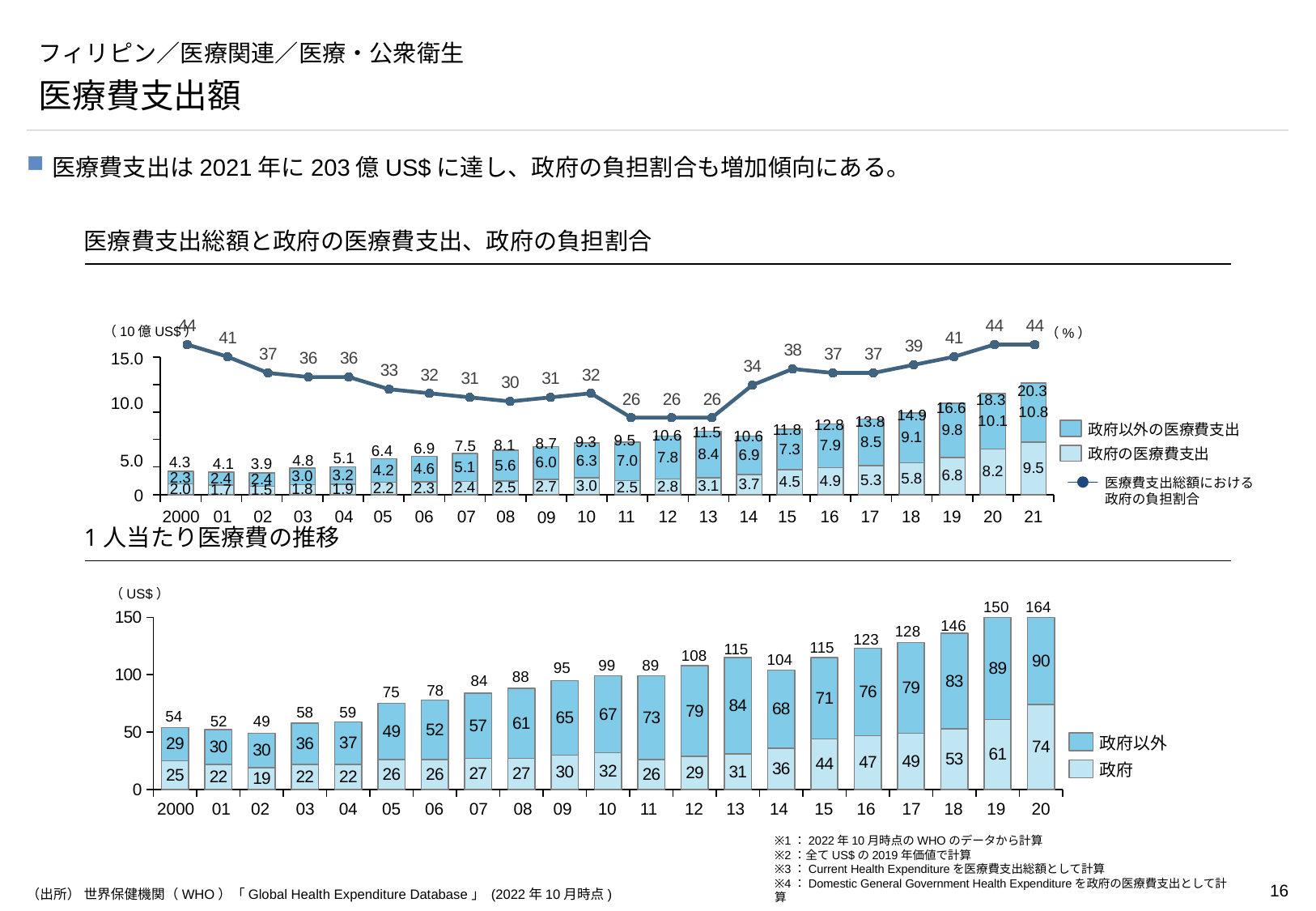
What kind of chart is the bottom chart (1人当たり医療費の推移)? stacked bar chart In the top chart, what is the government health expenditure (政府の医療費支出) for 2020? 8.2 In the top chart, what is the government's share of total health expenditure (政府の負担割合) in 2011? 26 In the top chart, how many series does the legend list? 3 In the bottom chart, how many years are shown on the x axis? 21 In the top chart (医療費支出総額と政府の医療費支出、政府の負担割合), what is the total health expenditure for 2021? 20.3 In the top chart, what is the difference between the non-government expenditure (10.8) and the government expenditure (9.5) in 2021? 1.3 In the top chart, which year has the lowest total health expenditure? 2002 In the bottom chart, is the per-capita total for 2013 larger or smaller than that for 2014? larger In the bottom chart, which year has the highest per-capita health expenditure? 2020 In the bottom chart (1人当たり医療費の推移), what is the per-capita health expenditure total for 2020? 164 In the bottom chart, what is the government (政府) per-capita expenditure for 2019? 61